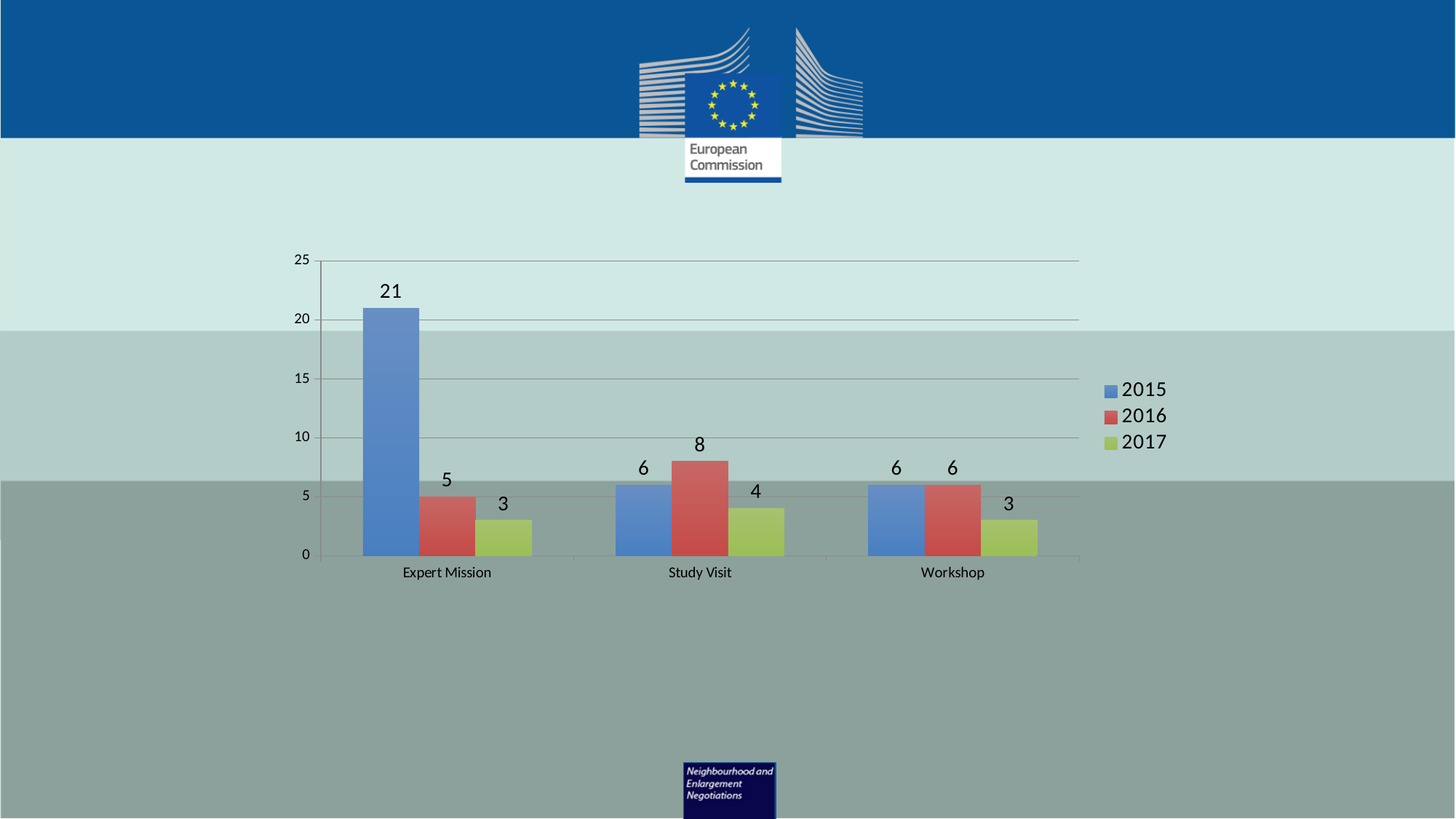
What is the value for Workshop in 2017? 3 Is the value for Expert Mission in 2015 greater or less than 20? greater How many categories are shown on the x axis? 3 What kind of chart is shown on the slide? bar chart Which colour represents 2017 in the legend? green What is the difference between the 2015 and 2016 values for Expert Mission? 16 Which category has the lowest value for 2016? Expert Mission What is the value for Expert Mission in 2015? 21 Which is larger for Study Visit: the 2015 value or the 2016 value? 2016 Which category has the highest value for 2015? Expert Mission How many series does the legend list? 3 What is the value for Study Visit in 2016? 8